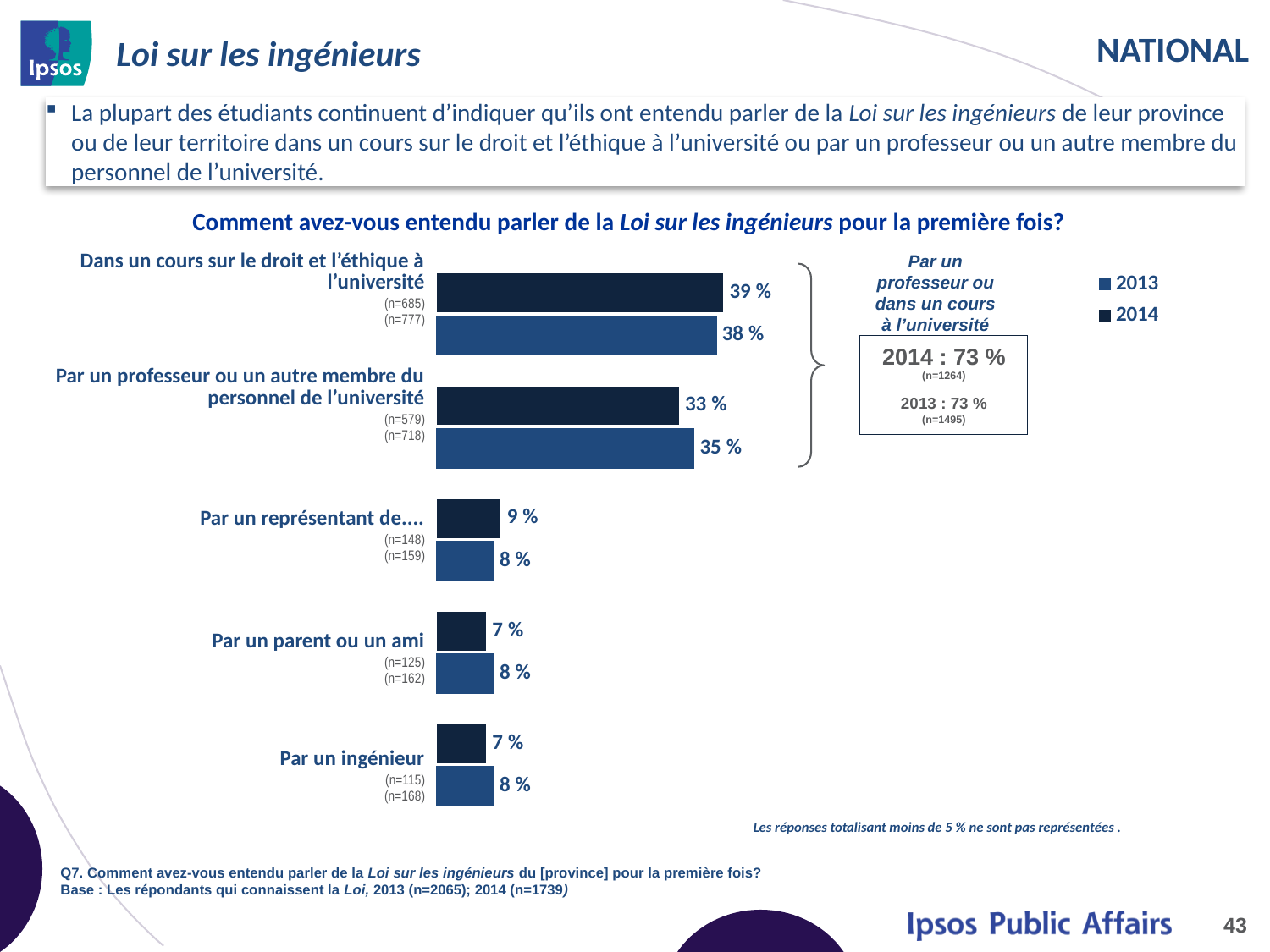
What is the difference between the 2013 and 2014 values for 'Par un professeur ou un autre membre du personnel de l'université'? 2 % Which is larger for 'Par un représentant de....': the 2013 value or the 2014 value? 2014 What is the 2013 value for 'Par un ingénieur'? 8 % What kind of chart is shown on the slide? bar chart What is the 2013 value for 'Par un professeur ou un autre membre du personnel de l'université'? 35 % What is the 2014 value for 'Par un parent ou un ami'? 7 % Which category has the highest 2014 value? Dans un cours sur le droit et l'éthique à l'université What is the 2014 value for 'Dans un cours sur le droit et l'éthique à l'université'? 39 % Which series is shown in the darker navy colour in the legend? 2014 How many response categories are plotted in the chart? 5 How many series does the legend list? 2 What combined percentage is shown in the box for 'Par un professeur ou dans un cours à l'université' in 2014? 73 %